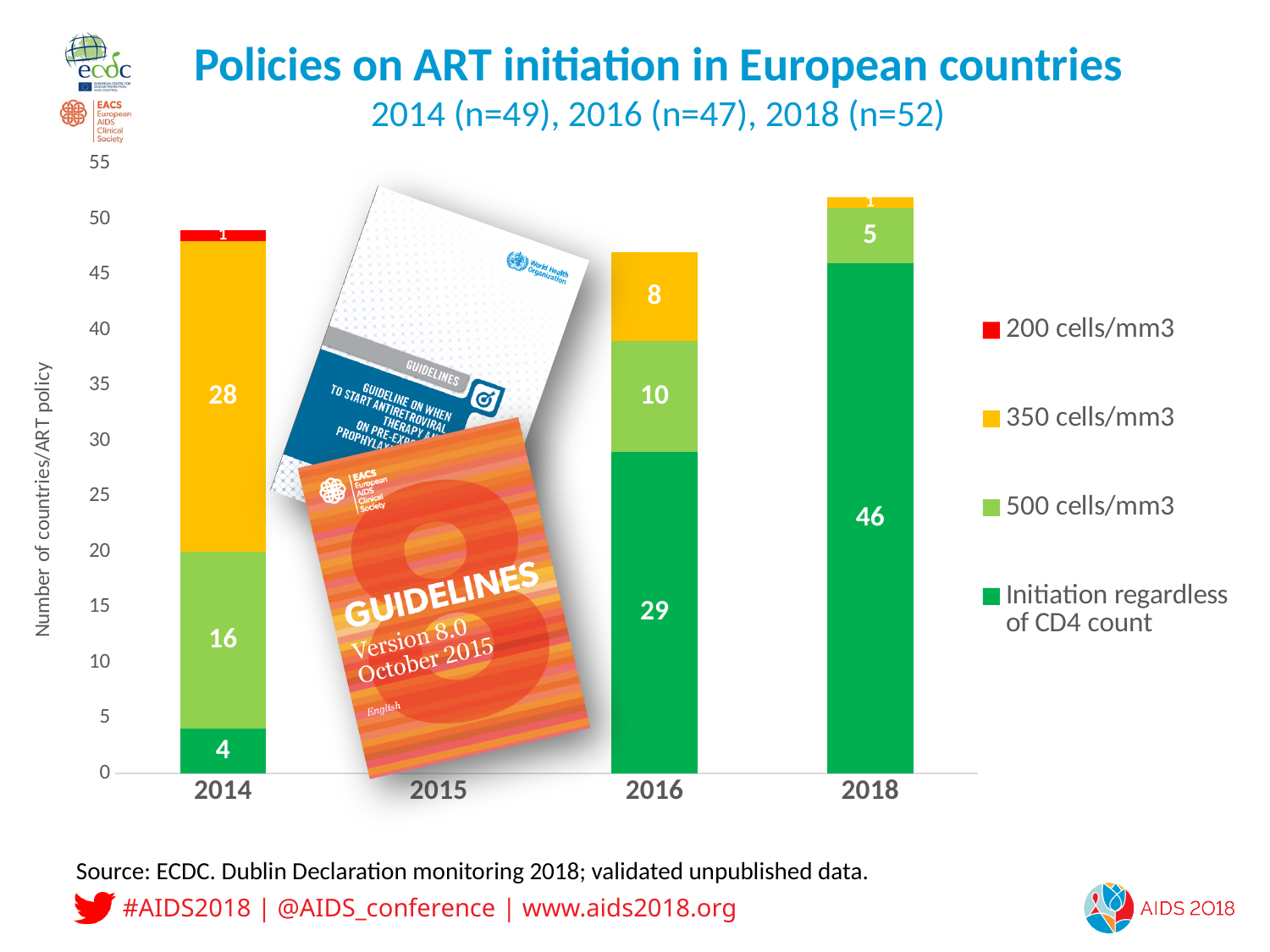
In which year is the value for '350 cells/mm3' lowest? 2018 Which is larger: the '500 cells/mm3' value in 2014 or in 2016? 2014 What is the value for 'Initiation regardless of CD4 count' in 2014? 4 What is the value for '350 cells/mm3' in 2014? 28 How many series does the legend list? 4 What is the value for 'Initiation regardless of CD4 count' in 2018? 46 In which year is the value for 'Initiation regardless of CD4 count' highest? 2018 What is the value for '500 cells/mm3' in 2016? 10 What type of chart is shown on the slide? stacked bar chart What is the total of the stacked bar for 2016? 47 What is the y-axis title of the chart? Number of countries/ART policy What is the difference between the 'Initiation regardless of CD4 count' values for 2018 and 2016? 17